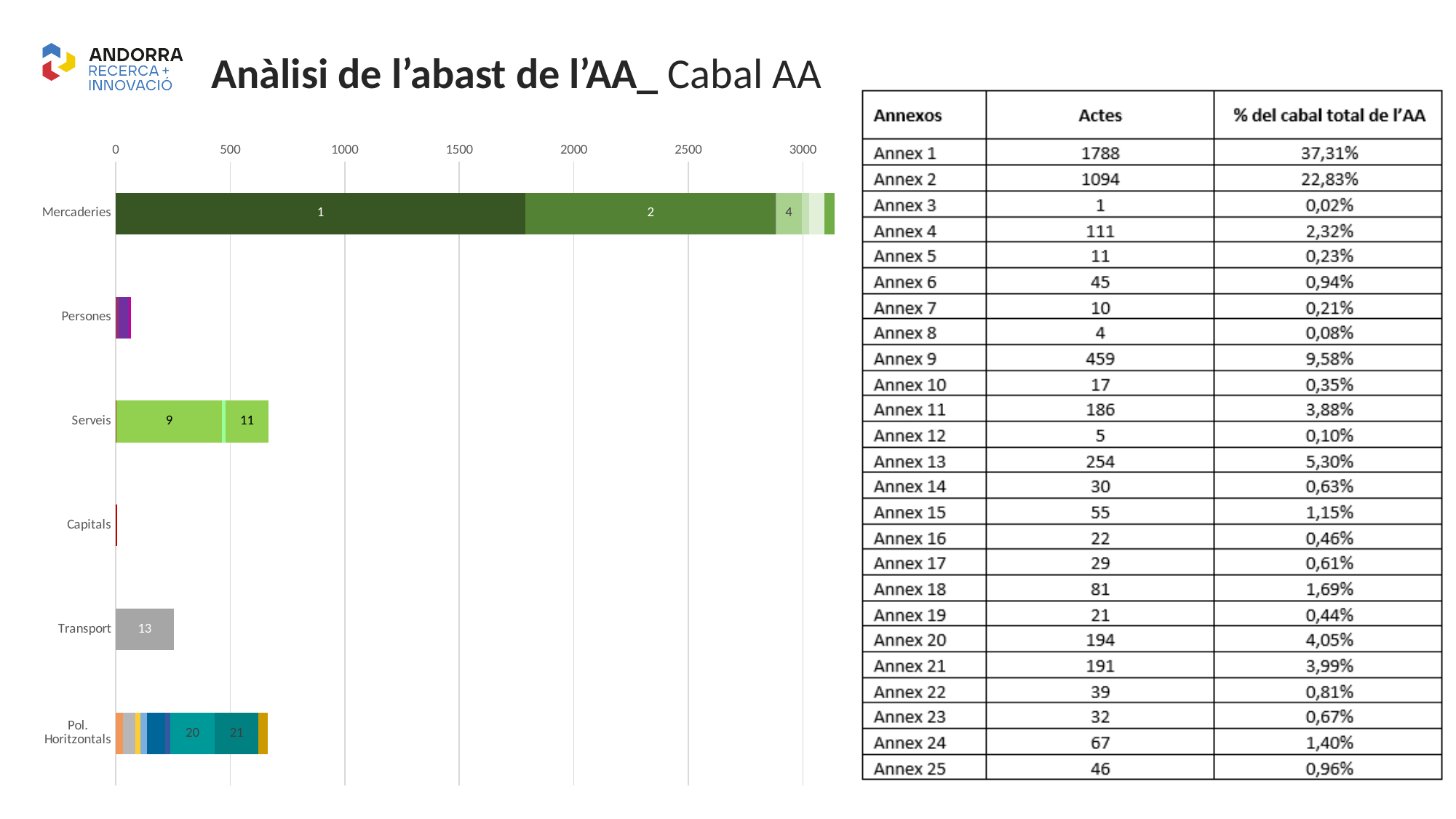
Is the total bar length for Mercaderies greater or less than 2500? greater Which bar is longer, Mercaderies or Serveis? Mercaderies Is the total bar length for Serveis greater or less than 500? greater Which category has the shortest bar in the chart? Capitals Which bar is longer, Transport or Persones? Transport Is the bar for Transport greater or less than 500? less What kind of chart is shown on the left of the slide? bar chart How many categories are shown on the vertical axis of the bar chart? 6 What label is printed on the largest (dark green) segment of the Mercaderies bar? 1 Which category has the longest bar in the chart? Mercaderies What label is printed on the Transport bar? 13